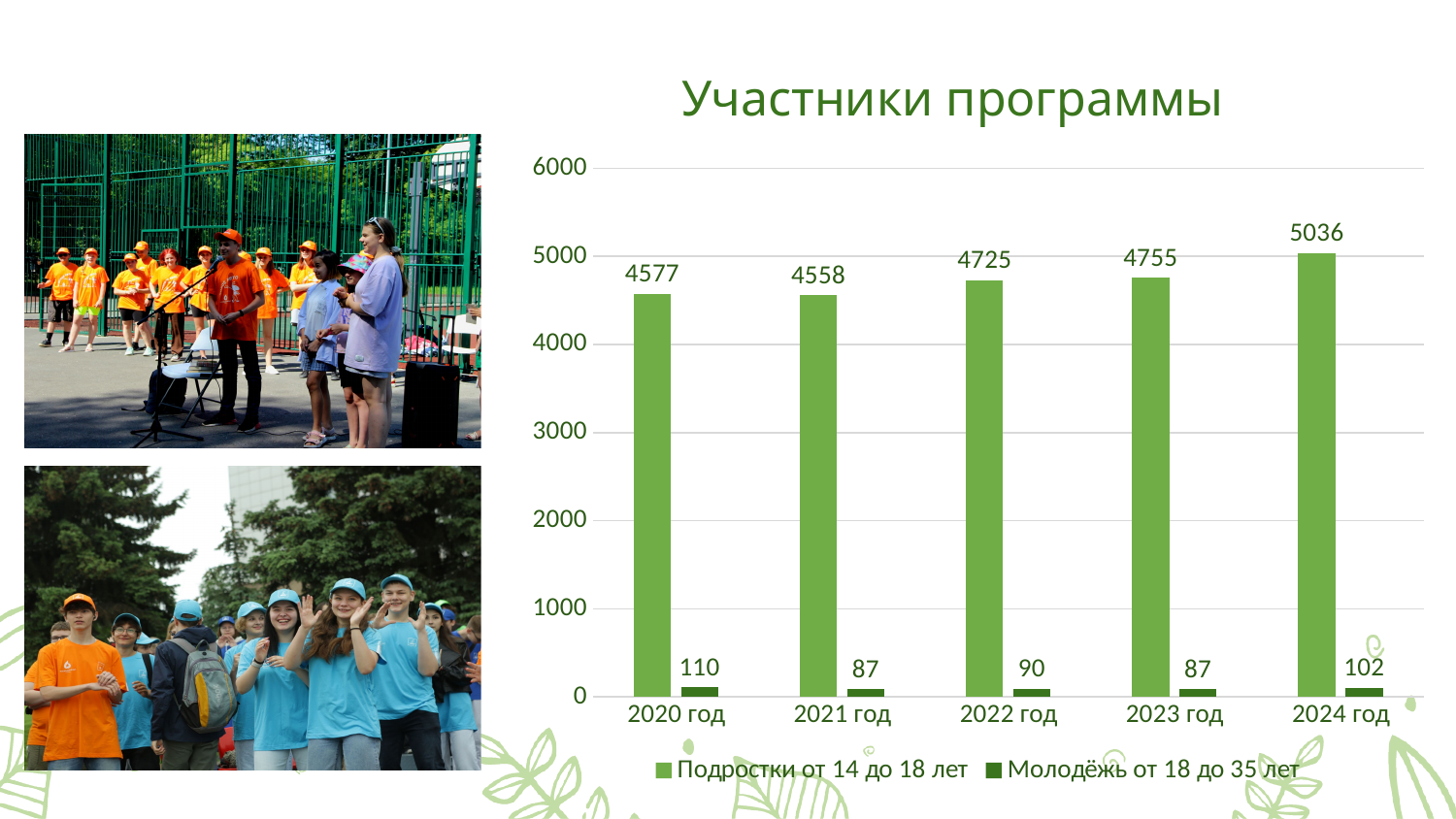
Which is larger: the "Молодёжь от 18 до 35 лет" value for 2022 год or for 2024 год? 2024 год What is the difference between the "Подростки от 14 до 18 лет" values for 2024 год and 2023 год? 281 What is the value for "Молодёжь от 18 до 35 лет" in 2020 год? 110 How many years are shown on the x axis? 5 Which year has the highest value for "Молодёжь от 18 до 35 лет"? 2020 год What is the value for "Подростки от 14 до 18 лет" in 2021 год? 4558 What is the value for "Подростки от 14 до 18 лет" in 2024 год? 5036 What is the title of the chart? Участники программы Which year has the lowest value for "Подростки от 14 до 18 лет"? 2021 год How many series does the legend list? 2 Is the value for "Подростки от 14 до 18 лет" in 2024 год greater or less than 5000? greater Which year has the highest value for "Подростки от 14 до 18 лет"? 2024 год